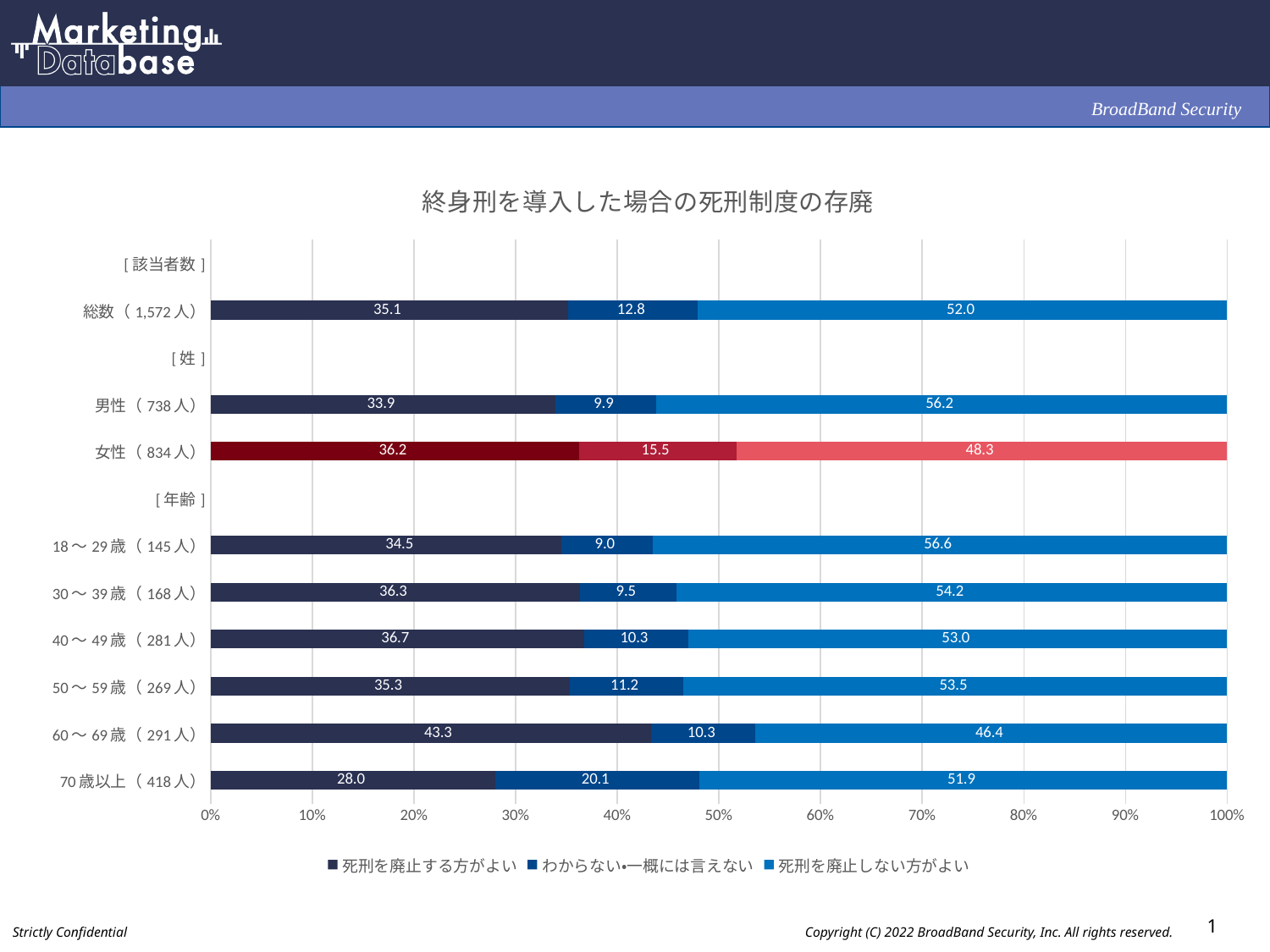
What is the title of the chart? 終身刑を導入した場合の死刑制度の存廃 What kind of chart is shown on the slide? Stacked bar chart What is the value of 死刑を廃止しない方がよい for 男性 (738人)? 56.2 Which is larger, the 死刑を廃止しない方がよい value for 18～29歳 (145人) or for 60～69歳 (291人)? 18～29歳 (145人) How many series does the legend list? 3 What is the value of 死刑を廃止する方がよい for 総数 (1,572人)? 35.1 What is the difference between the わからない・一概には言えない values for 女性 (834人) and 男性 (738人)? 5.6 How many categories have data bars plotted in the chart? 9 What is the total of the three segments for 総数 (1,572人)? 99.9 Which category has the highest value for 死刑を廃止する方がよい? 60～69歳 (291人) What is the value of わからない・一概には言えない for 70歳以上 (418人)? 20.1 Which category has the lowest value for 死刑を廃止する方がよい? 70歳以上 (418人)